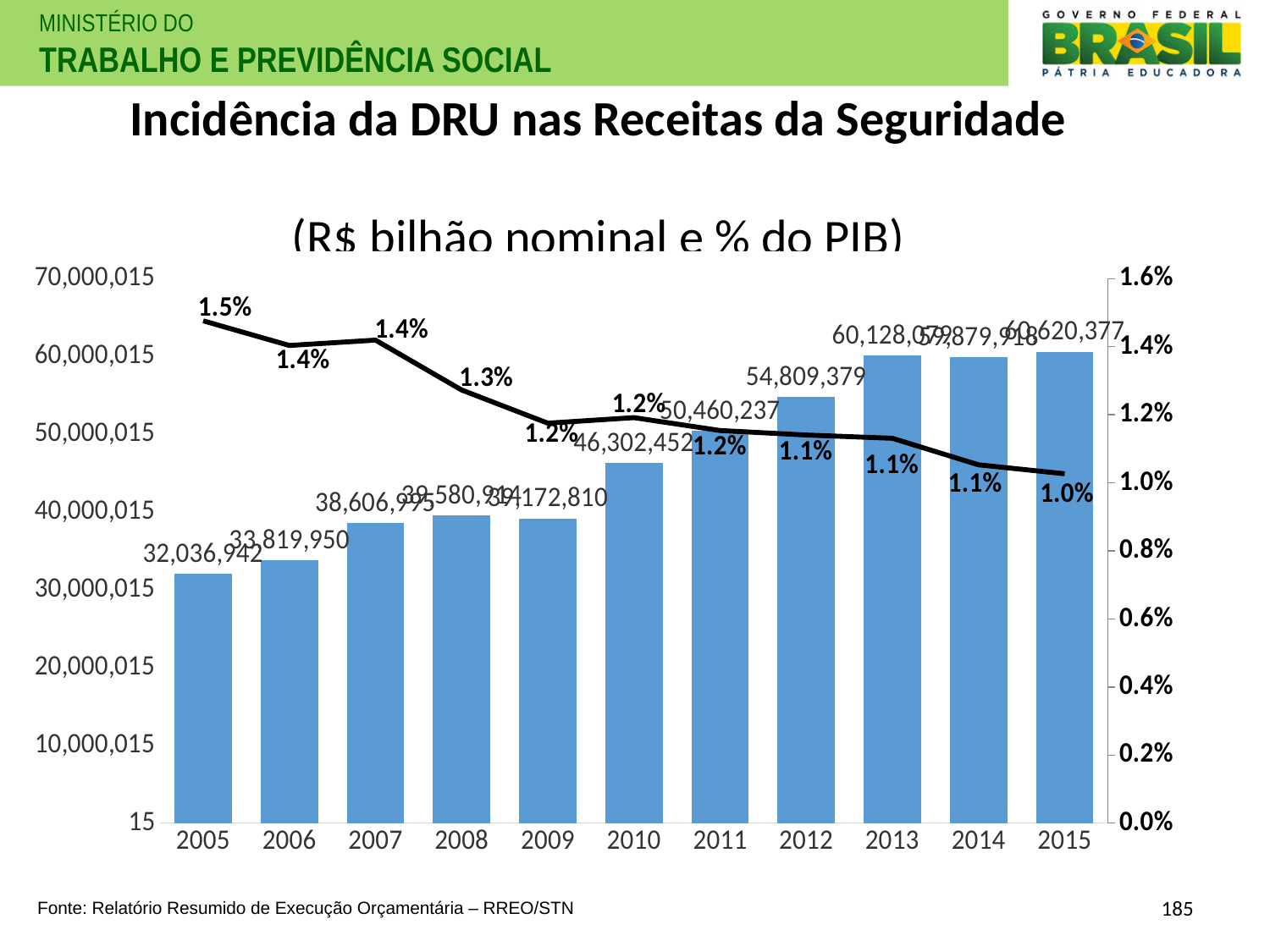
What percentage of PIB does the line show for 2015? 1.0% Which year has the lowest bar value? 2005 Does the percentage of PIB line rise or fall from 2005 to 2015? fall What is the value of the bar for 2012? 54,809,379 Which is larger, the bar value for 2012 or for 2010? 2012 What percentage of PIB does the line show for 2005? 1.5% What is the difference between the bar values for 2011 and 2010? 4,157,785 What is the value of the bar for 2005? 32,036,942 How many years are shown on the x axis? 11 What is the value of the bar for 2010? 46,302,452 Is the bar value for 2009 greater or less than 40,000,015? less Which year has the highest percentage of PIB on the line? 2005